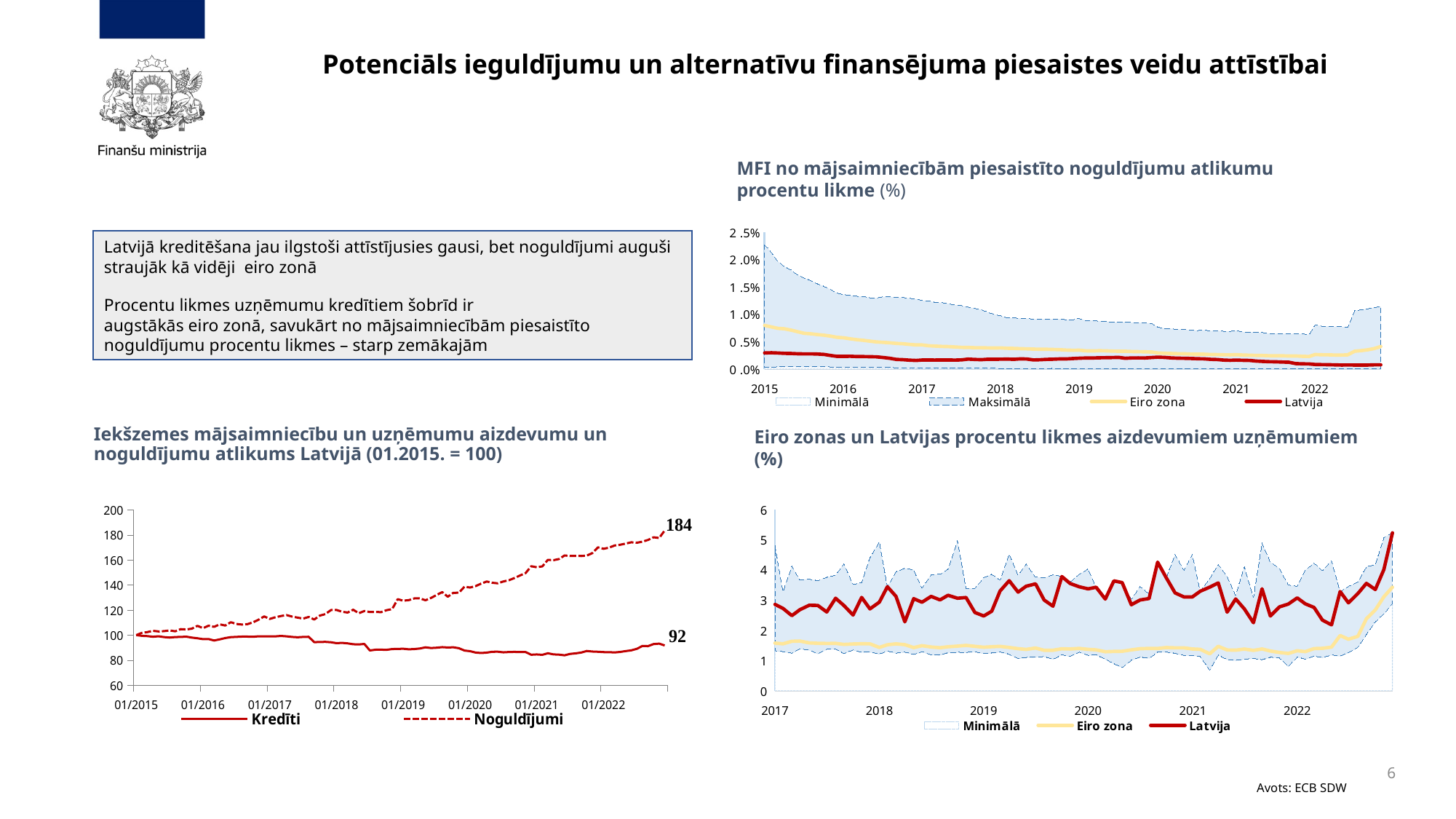
In the chart titled "MFI no mājsaimniecībām piesaistīto noguldījumu atlikumu procentu likme (%)", is the value for Latvija at the start of 2015 greater or less than 0.5%? less How many series does the legend of the bottom-left chart list? 2 In the bottom-left chart, what is the difference between the final labelled values of Noguldījumi and Kredīti? 92 How many series does the legend of the chart titled "Eiro zonas un Latvijas procentu likmes aizdevumiem uzņēmumiem (%)" list? 3 In the chart titled "MFI no mājsaimniecībām piesaistīto noguldījumu atlikumu procentu likme (%)", which is higher at the start of 2015, Eiro zona or Latvija? Eiro zona In the bottom-left chart, which series ends higher, Kredīti or Noguldījumi? Noguldījumi What kind of chart is the bottom-left chart? line chart In the bottom-left chart, does the Noguldījumi series rise or fall from 01/2015 to the end of the period? rise In the chart titled "Iekšzemes mājsaimniecību un uzņēmumu aizdevumu un noguldījumu atlikums Latvijā (01.2015. = 100)", what is the final labelled value of the Noguldījumi series? 184 How many series does the legend of the chart titled "MFI no mājsaimniecībām piesaistīto noguldījumu atlikumu procentu likme (%)" list? 4 In the chart titled "Iekšzemes mājsaimniecību un uzņēmumu aizdevumu un noguldījumu atlikums Latvijā (01.2015. = 100)", what is the final labelled value of the Kredīti series? 92 In the chart titled "Eiro zonas un Latvijas procentu likmes aizdevumiem uzņēmumiem (%)", is the value for Eiro zona at the start of 2017 greater or less than 2? less